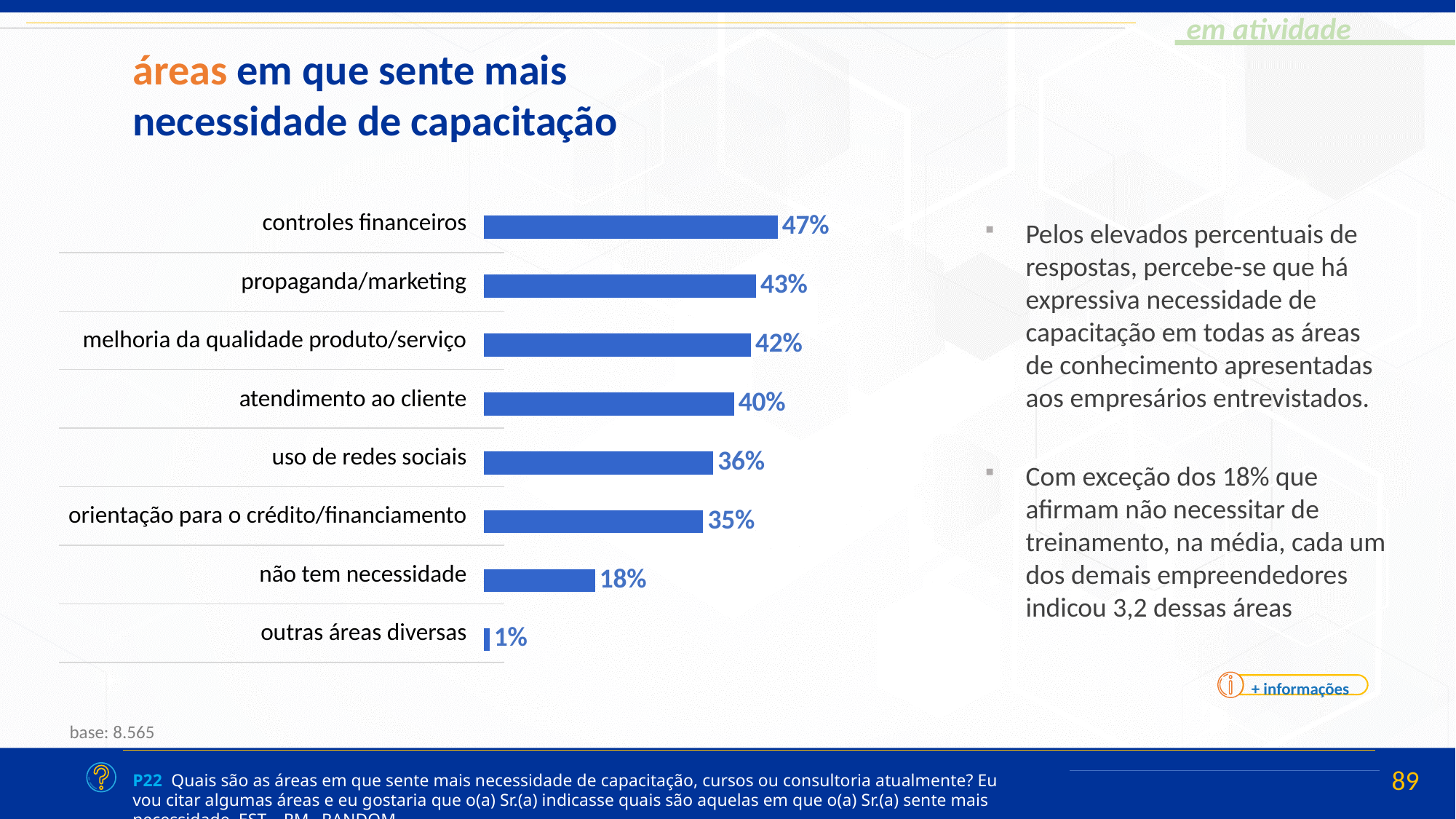
What is the value for não tem necessidade? 18% What is the value for orientação para o crédito/financiamento? 35% What is the base (number of respondents) shown below the chart? 8.565 What is the value for controles financeiros? 47% What is the value for uso de redes sociais? 36% What kind of chart is shown on the slide? bar chart How many categories are shown in the chart? 8 Which category has the lowest value? outras áreas diversas Which category has the highest value? controles financeiros Which is larger, melhoria da qualidade produto/serviço or uso de redes sociais? melhoria da qualidade produto/serviço What is the difference between atendimento ao cliente and não tem necessidade? 22% What is the difference between controles financeiros and propaganda/marketing? 4%